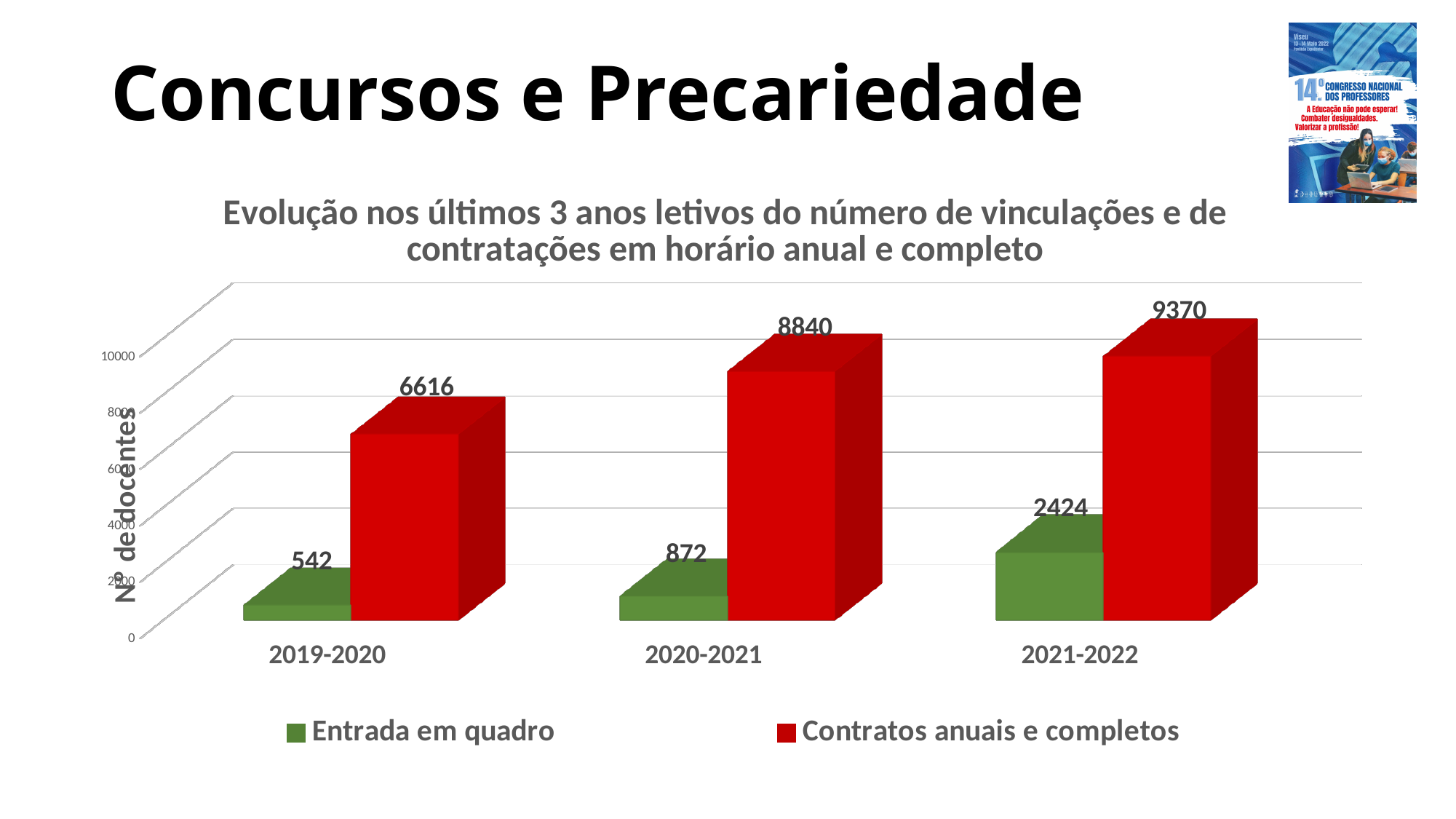
What is the value of "Contratos anuais e completos" for 2020-2021? 8840 How many school years are shown on the x axis? 3 What is the value of "Entrada em quadro" for 2019-2020? 542 In which school year is "Contratos anuais e completos" highest? 2021-2022 What is the value of "Contratos anuais e completos" for 2019-2020? 6616 What kind of chart is shown on the slide? Bar chart What is the value of "Entrada em quadro" for 2021-2022? 2424 Which is larger in 2020-2021: "Entrada em quadro" or "Contratos anuais e completos"? Contratos anuais e completos Does "Entrada em quadro" rise or fall from 2019-2020 to 2021-2022? Rise How many series does the legend list? 2 What is the difference between "Contratos anuais e completos" and "Entrada em quadro" in 2021-2022? 6946 In which school year is "Entrada em quadro" lowest? 2019-2020